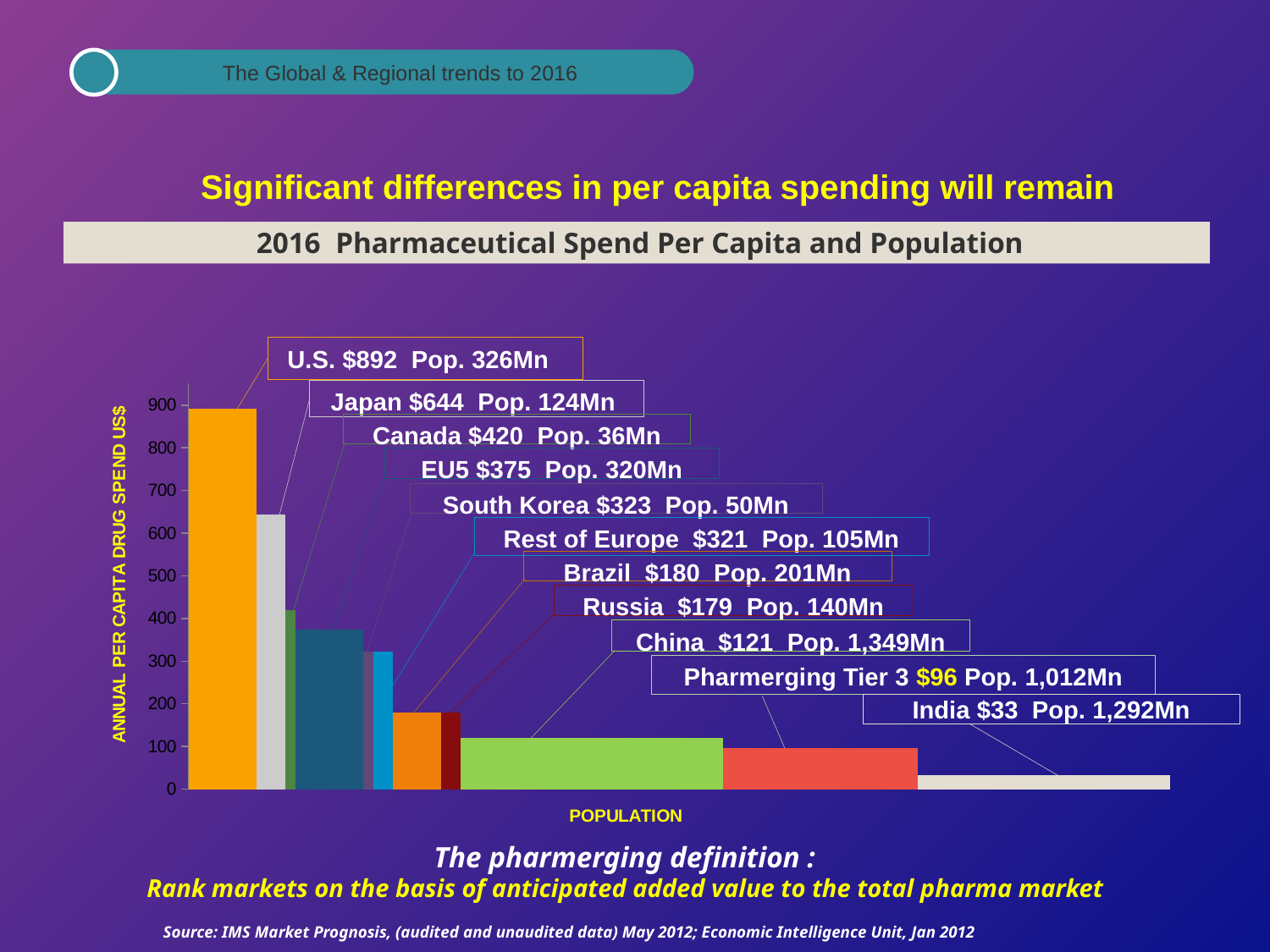
What is the per capita pharmaceutical spend for Pharmerging Tier 3? $96 Which has a larger population, India or Pharmerging Tier 3? India What is the label of the vertical axis of the chart? ANNUAL PER CAPITA DRUG SPEND US$ How many markets are labelled on the chart? 11 What is the population shown for China? 1,349Mn Which has a larger per capita spend, Canada or South Korea? Canada What kind of chart is shown on the slide? Bar chart What is the difference in per capita spend between Canada and EU5? $45 Which market has the lowest per capita drug spend? India Which market has the highest per capita drug spend? U.S. What is the 2016 per capita pharmaceutical spend for the U.S.? $892 What is the difference in per capita spend between the U.S. and Japan? $248